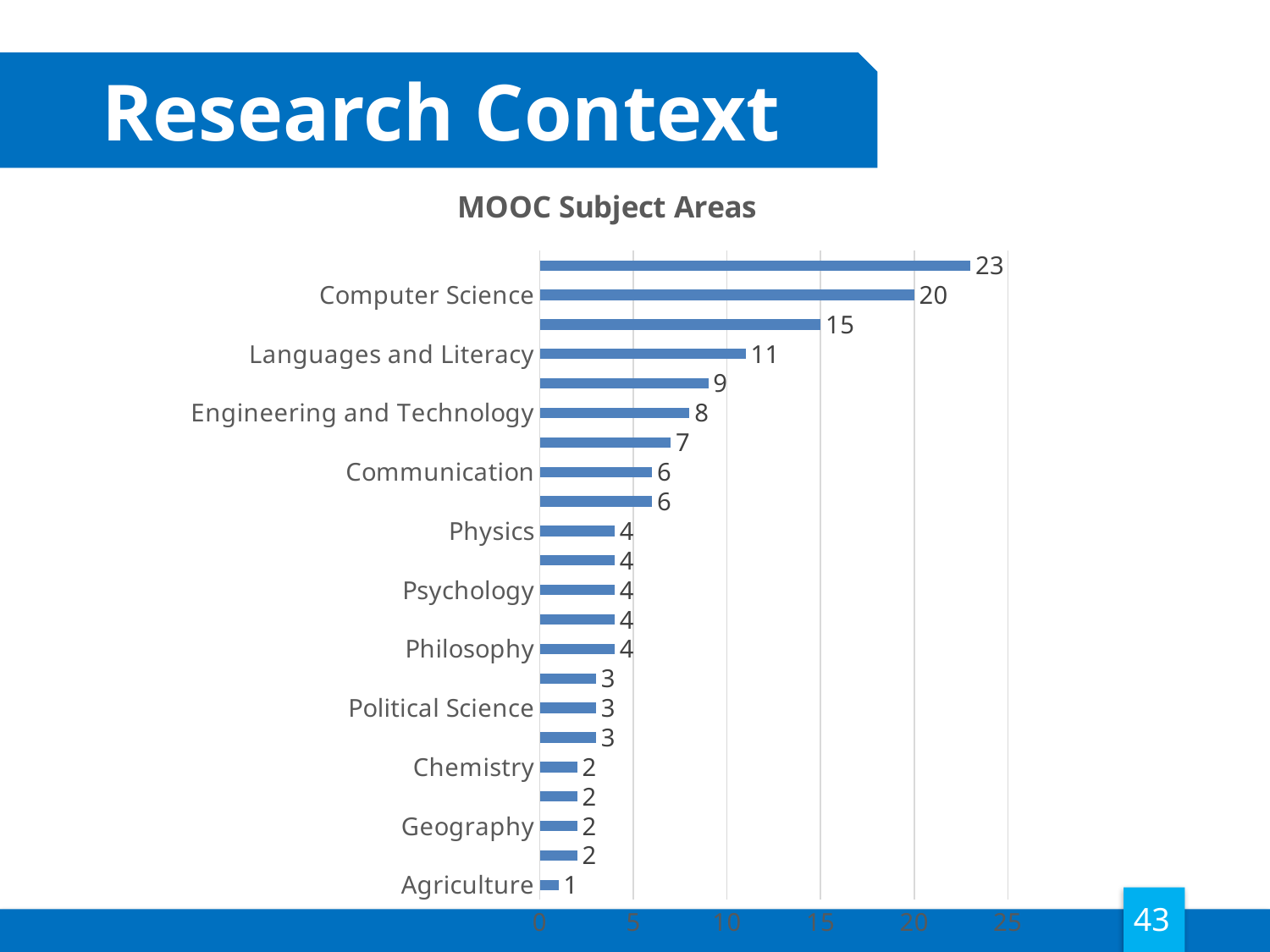
What type of chart is shown on the slide? bar chart What is the value for Languages and Literacy? 11 What is the value for Agriculture? 1 Which labelled subject area has the lowest value? Agriculture What is the difference between the values for Computer Science and Languages and Literacy? 9 How many bars are plotted on the chart? 22 What is the value for Engineering and Technology? 8 What is the highest value shown on the chart? 23 What is the title of the chart? MOOC Subject Areas What is the value for Computer Science? 20 What is the value for Communication? 6 Which has a larger value, Physics or Political Science? Physics